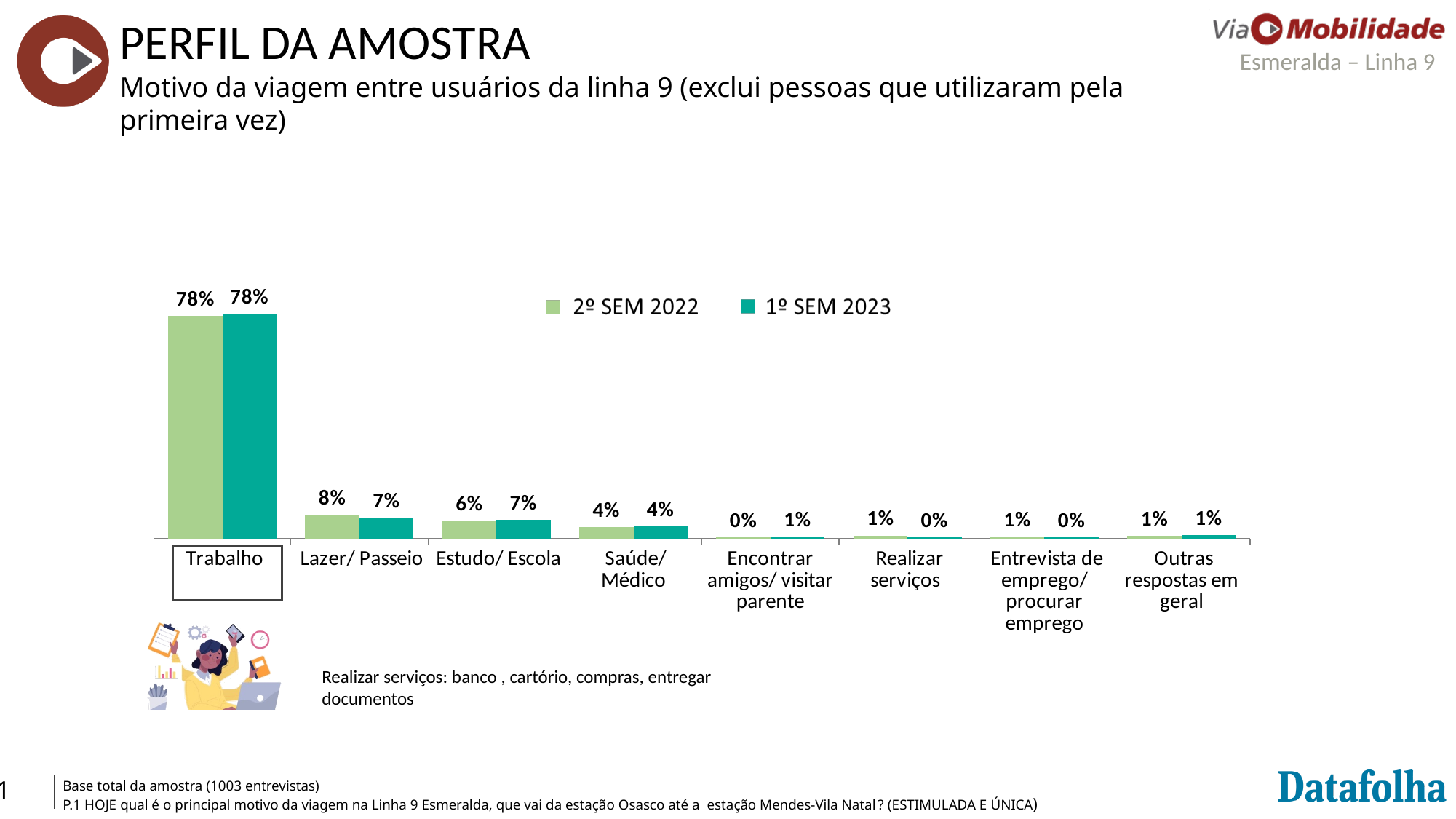
How many categories are shown on the x axis of the chart? 8 What is the value for Saúde/ Médico in the 2º SEM 2022 series? 4% Which is larger for Estudo/ Escola: the 2º SEM 2022 value or the 1º SEM 2023 value? 1º SEM 2023 What is the value for Lazer/ Passeio in the 2º SEM 2022 series? 8% What is the value for Estudo/ Escola in the 1º SEM 2023 series? 7% How many series does the legend list? 2 Which series is shown in light green in the legend? 2º SEM 2022 What is the difference between the Trabalho and Lazer/ Passeio values in the 2º SEM 2022 series? 70% What is the difference between the 2º SEM 2022 and 1º SEM 2023 values for Lazer/ Passeio? 1% What kind of chart is shown on the slide? Bar chart Which category has the highest value in the 1º SEM 2023 series? Trabalho What is the value for Trabalho in the 1º SEM 2023 series? 78%